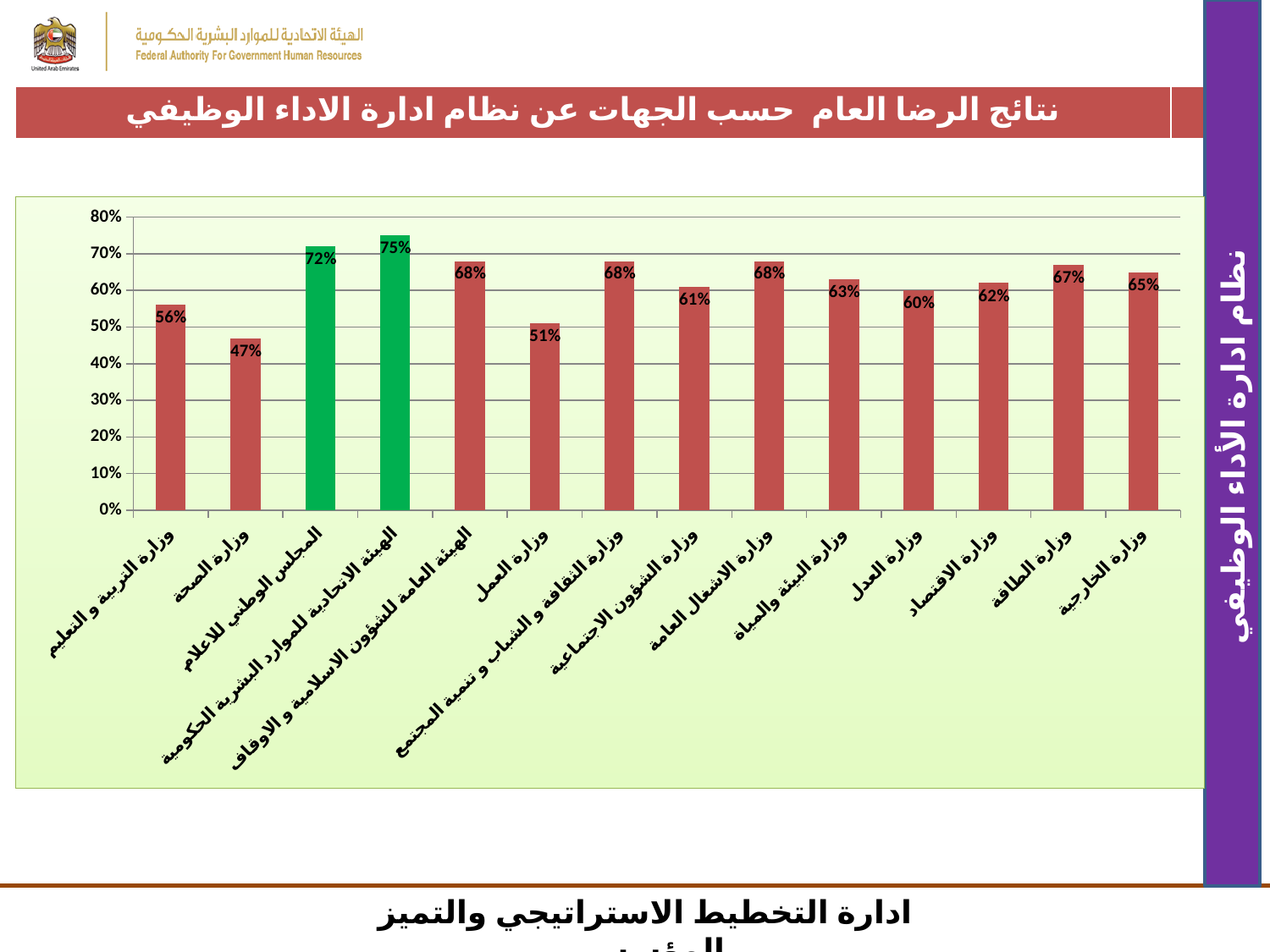
What is the difference between the values for المجلس الوطني للاعلام and وزارة التربية و التعليم? 16% What is the value for وزارة الصحة? 47% What is the value for وزارة العمل? 51% Which entity has the lowest value? وزارة الصحة Is the value for وزارة البيئة والمياه greater or less than 50%? greater Which is larger, the value for وزارة الطاقة or the value for وزارة العدل? وزارة الطاقة What is the value for وزارة الخارجية? 65% How many entities are shown on the x axis? 14 Which entity has the highest value? الهيئة الاتحادية للموارد البشرية الحكومية Which two bars are coloured green instead of red? المجلس الوطني للاعلام and الهيئة الاتحادية للموارد البشرية الحكومية What is the value for الهيئة الاتحادية للموارد البشرية الحكومية? 75% What kind of chart is shown on the slide? bar chart